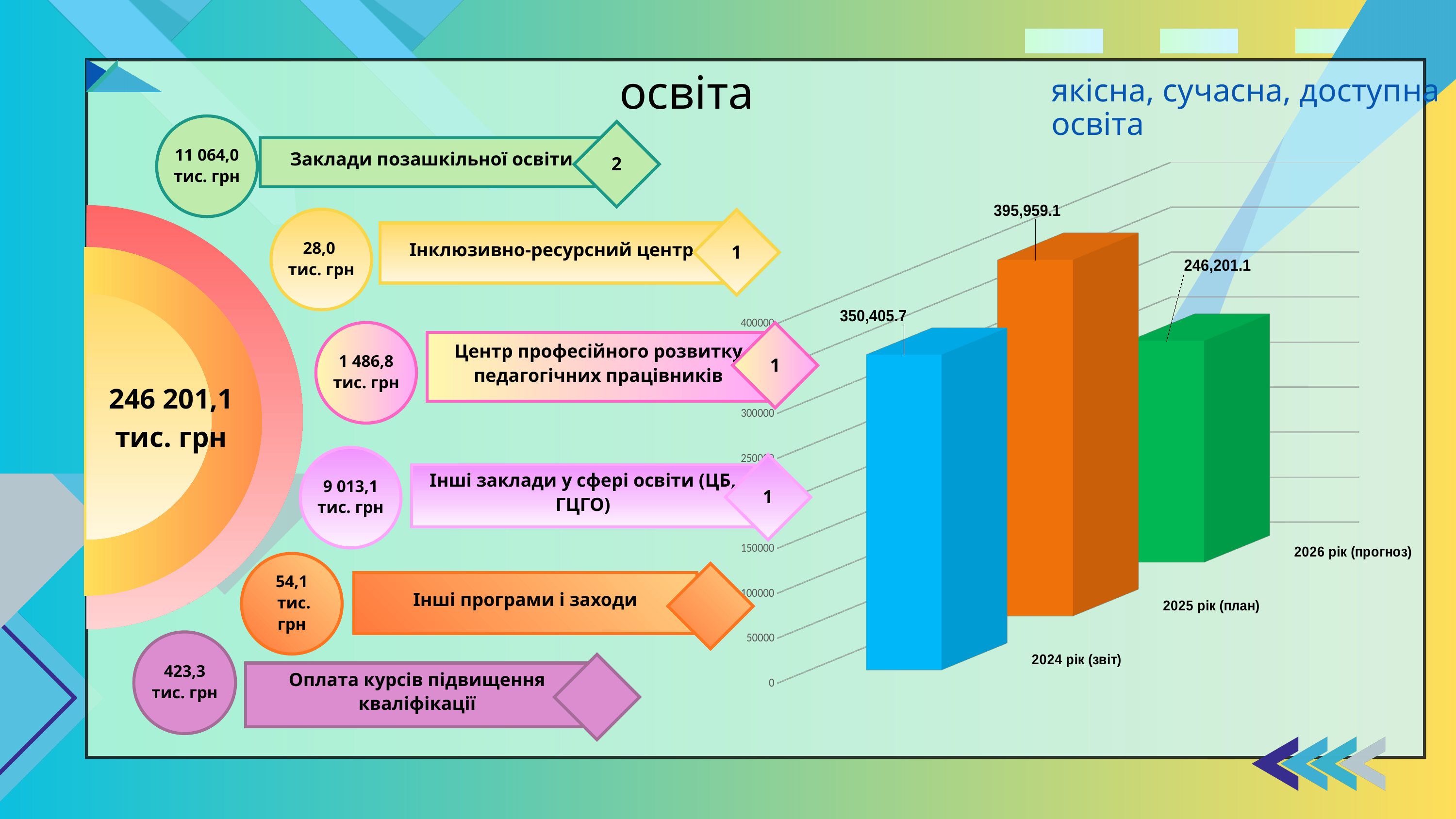
What is the value shown for 2024 рік (звіт) in the bar chart? 350,405.7 Is the value for 2026 рік (прогноз) greater or less than 300000? less What is the value shown for 2026 рік (прогноз) in the bar chart? 246,201.1 Which year has the lowest value in the bar chart? 2026 рік (прогноз) What kind of chart is shown on the right side of the slide? bar chart How many bars are plotted in the bar chart? 3 What is the difference between the values for 2024 рік (звіт) and 2026 рік (прогноз)? 104,204.6 Does the value rise or fall from 2025 рік (план) to 2026 рік (прогноз)? fall What is the value shown for 2025 рік (план) in the bar chart? 395,959.1 What is the difference between the values for 2025 рік (план) and 2024 рік (звіт)? 45,553.4 Which is larger in the bar chart: the value for 2024 рік (звіт) or for 2026 рік (прогноз)? 2024 рік (звіт) Which year has the highest value in the bar chart? 2025 рік (план)